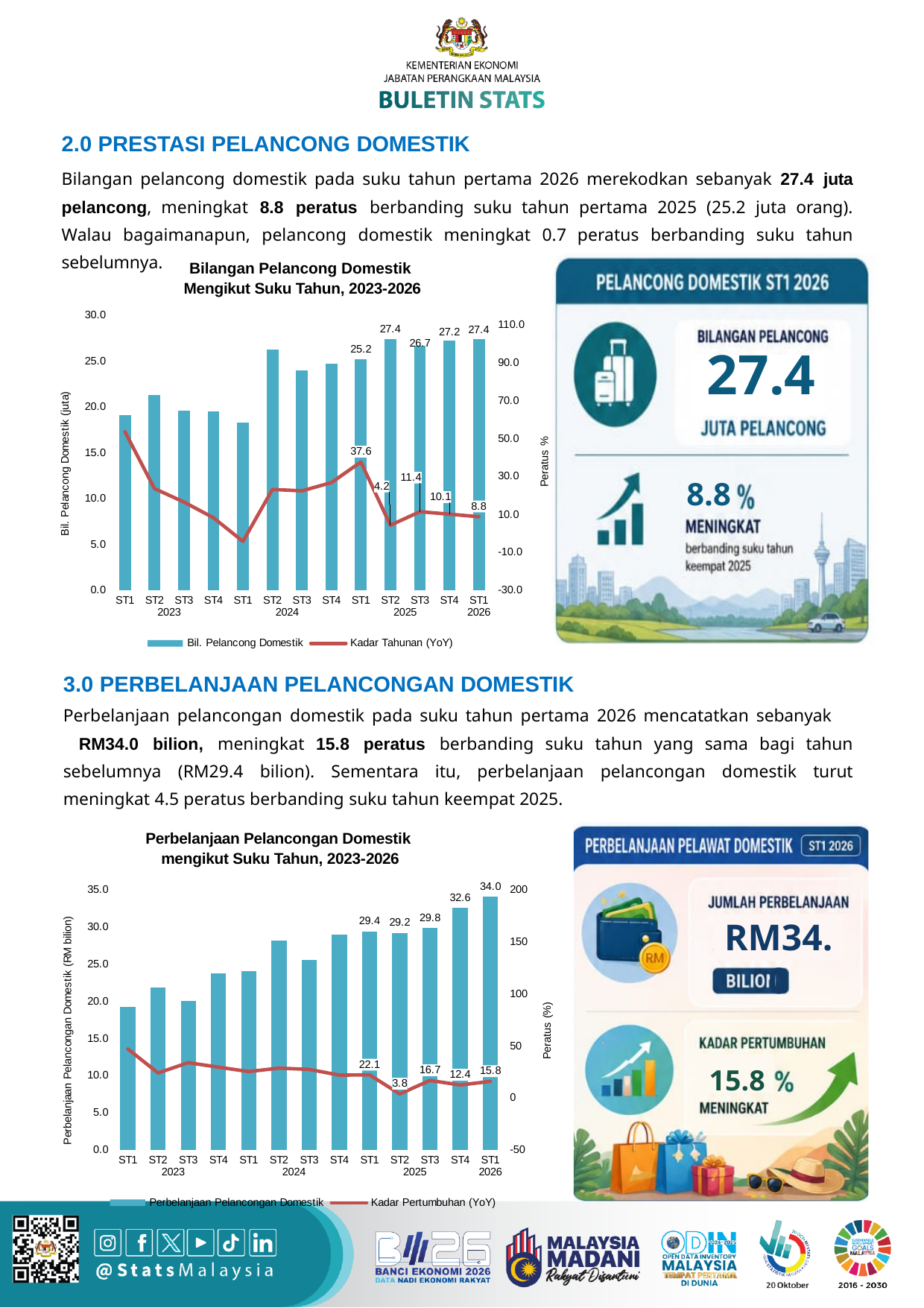
In the chart 'Bilangan Pelancong Domestik Mengikut Suku Tahun, 2023-2026', what is the value of Bil. Pelancong Domestik for ST1 2026? 27.4 In the chart 'Bilangan Pelancong Domestik Mengikut Suku Tahun, 2023-2026', what is the legend label of the line series? Kadar Tahunan (YoY) In the chart 'Bilangan Pelancong Domestik Mengikut Suku Tahun, 2023-2026', what is the Kadar Tahunan (YoY) value for ST2 2025? 4.2 In the chart 'Bilangan Pelancong Domestik Mengikut Suku Tahun, 2023-2026', how many series does the legend list? 2 In the chart 'Bilangan Pelancong Domestik Mengikut Suku Tahun, 2023-2026', is the Bil. Pelancong Domestik value for ST1 2024 greater or less than 20.0? less In the chart 'Perbelanjaan Pelancongan Domestik mengikut Suku Tahun, 2023-2026', what is the difference between the Perbelanjaan Pelancongan Domestik values for ST1 2026 and ST1 2025? 4.6 In the chart 'Perbelanjaan Pelancongan Domestik mengikut Suku Tahun, 2023-2026', which is larger, the Perbelanjaan Pelancongan Domestik for ST3 2025 or for ST2 2025? ST3 2025 In the chart 'Bilangan Pelancong Domestik Mengikut Suku Tahun, 2023-2026', what is the difference between the Bil. Pelancong Domestik values for ST1 2026 and ST1 2025? 2.2 In the chart 'Bilangan Pelancong Domestik Mengikut Suku Tahun, 2023-2026', which quarter has the lowest labelled Kadar Tahunan (YoY) value? ST2 2025 In the chart 'Perbelanjaan Pelancongan Domestik mengikut Suku Tahun, 2023-2026', which quarter has the highest Perbelanjaan Pelancongan Domestik? ST1 2026 In the chart 'Bilangan Pelancong Domestik Mengikut Suku Tahun, 2023-2026', how many quarters (bars) are plotted? 13 In the chart 'Perbelanjaan Pelancongan Domestik mengikut Suku Tahun, 2023-2026', what is the Perbelanjaan Pelancongan Domestik value for ST1 2026? 34.0